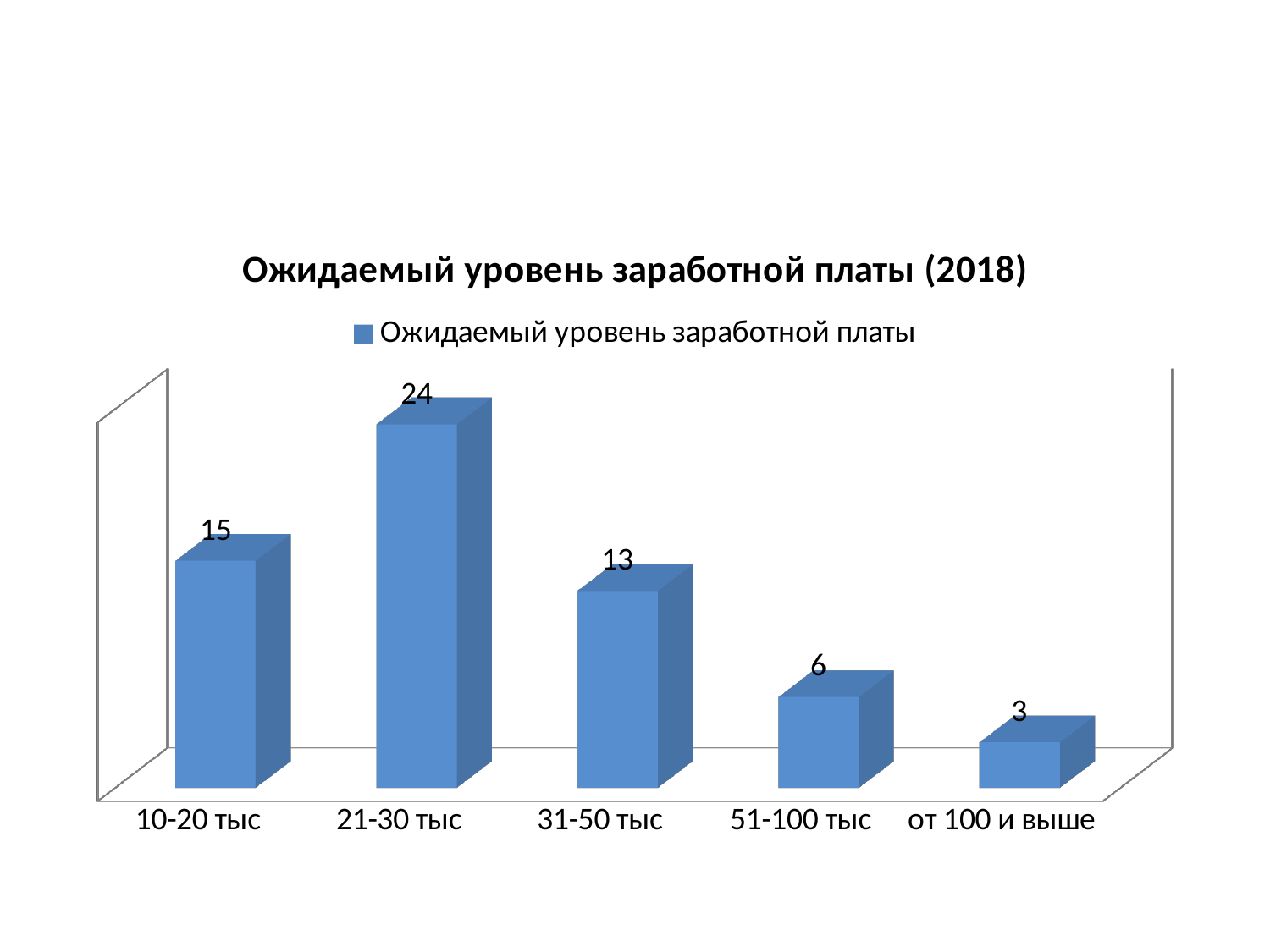
What is the value for the от 100 и выше category? 3 What is the title of the chart? Ожидаемый уровень заработной платы (2018) Which is larger, the value for 10-20 тыс or the value for 31-50 тыс? 10-20 тыс How many categories are shown on the x axis? 5 What is the difference between the values for 21-30 тыс and 51-100 тыс? 18 What is the value for the 10-20 тыс category? 15 Which category has the lowest value? от 100 и выше How many series does the legend list? 1 What kind of chart is shown on the slide? Bar chart What is the value for the 21-30 тыс category? 24 What is the value for the 31-50 тыс category? 13 Which category has the highest value? 21-30 тыс